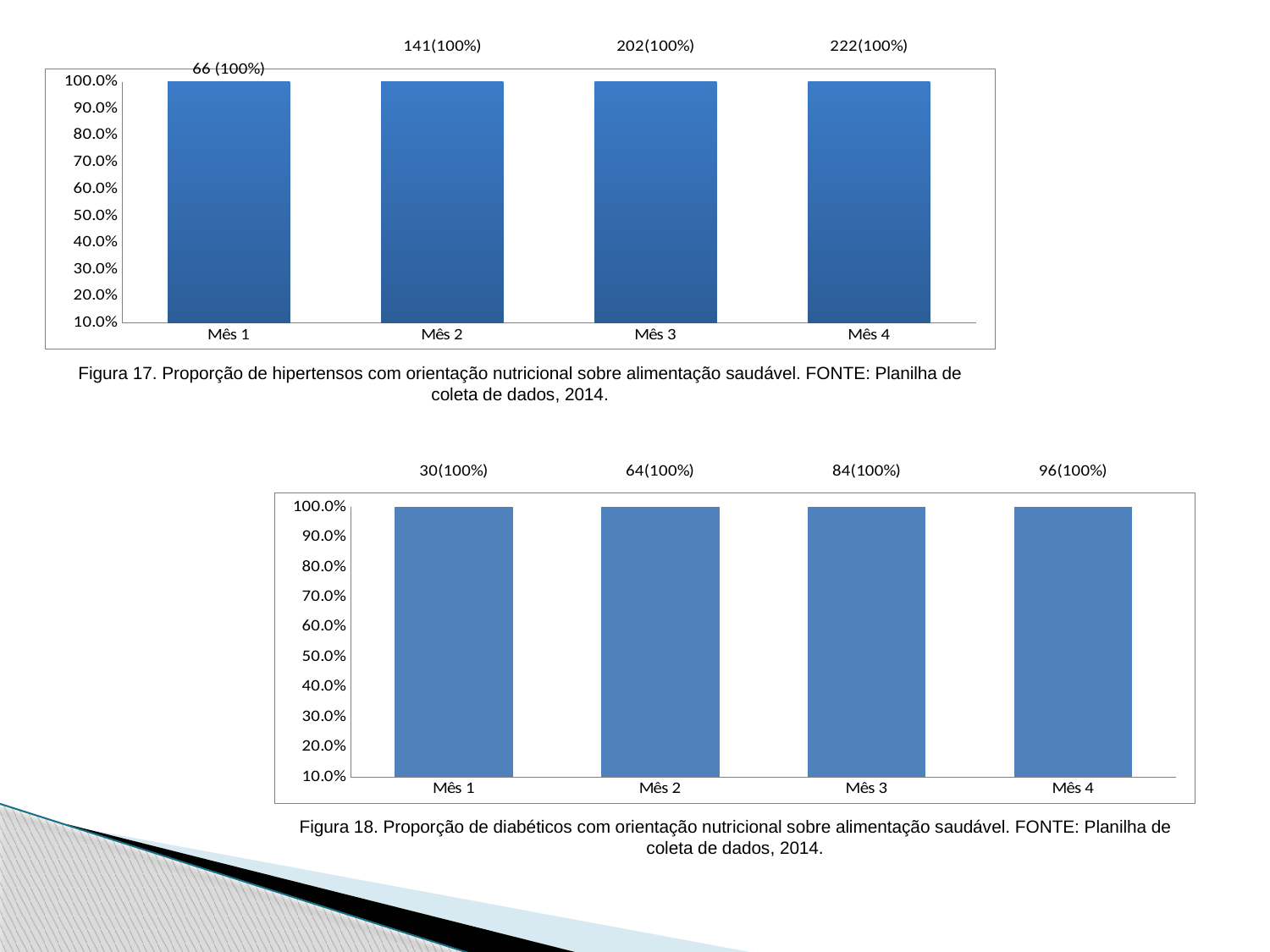
In the bottom chart (Figura 18, diabéticos), what is the data label shown above the bar for Mês 1? 30(100%) In the bottom chart (Figura 18, diabéticos), what percentage does the bar for Mês 4 reach? 100.0% In the top chart (Figura 17, hipertensos), what is the data label shown above the bar for Mês 4? 222(100%) What kind of chart is the top chart (Figura 17)? Bar chart In the top chart (Figura 17, hipertensos), what is the data label shown above the bar for Mês 1? 66 (100%) In the bottom chart (Figura 18), which month has the largest count in its data label? Mês 4 In the top chart (Figura 17), what is the difference between the counts in the data labels for Mês 4 and Mês 3? 20 How many bars (months) are plotted in the top chart (Figura 17)? 4 How many bars (months) are plotted in the bottom chart (Figura 18)? 4 In the top chart (Figura 17, hipertensos), what is the data label shown above the bar for Mês 2? 141(100%) In the top chart (Figura 17), do the percentage values rise, fall, or stay the same from Mês 1 to Mês 4? Stay the same In the bottom chart (Figura 18, diabéticos), what is the data label shown above the bar for Mês 3? 84(100%)